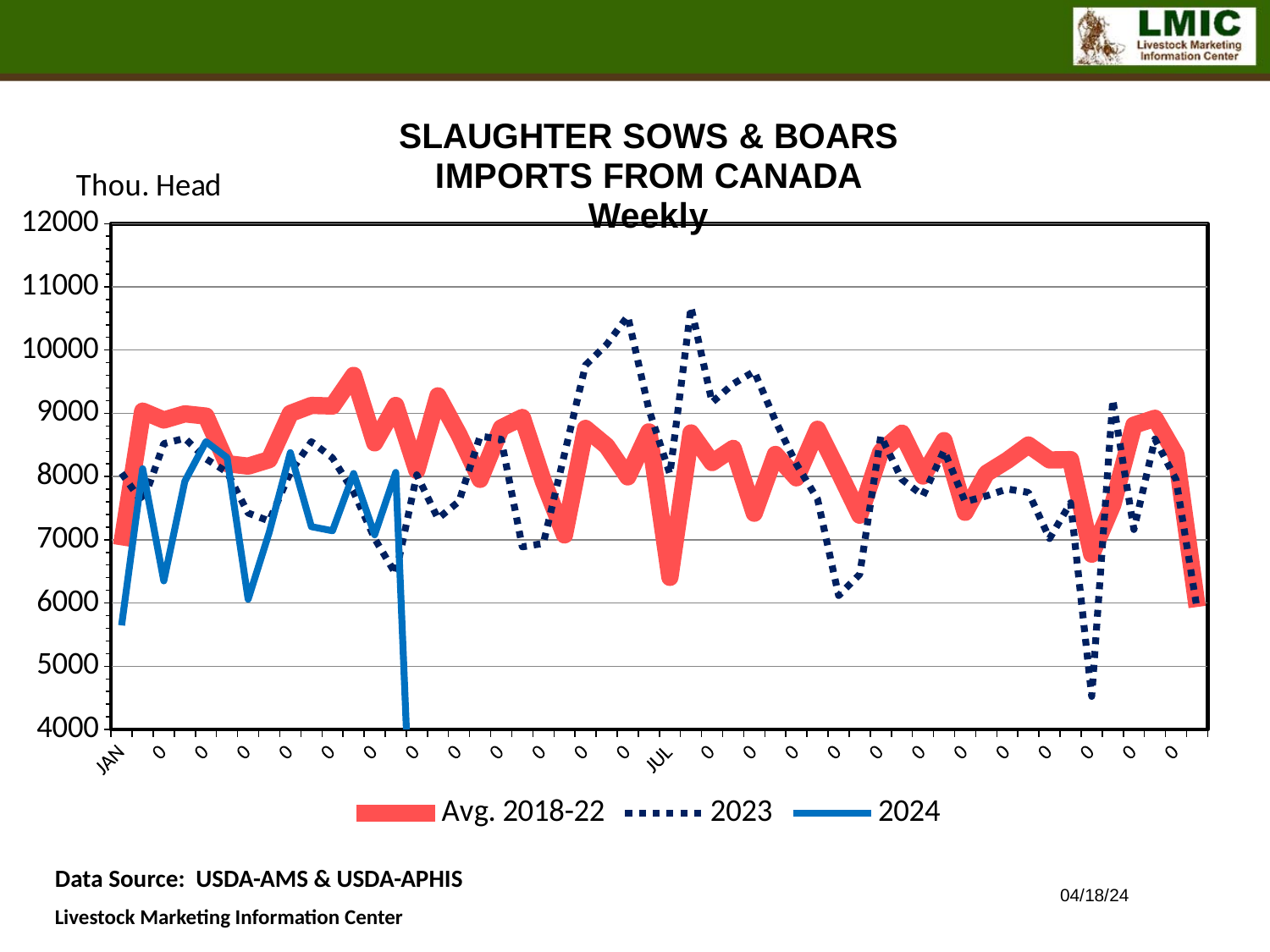
Is the first (JAN) value of the 2024 series greater or less than 6000? less Is the highest value of the Avg. 2018-22 series greater or less than 10000? less Which series reaches a higher peak value, 2023 or Avg. 2018-22? 2023 What kind of chart is shown on the slide? line chart Is the final value of the Avg. 2018-22 series at the right end of the chart greater or less than 7000? less How many series does the legend list? 3 Does the Avg. 2018-22 series rise or fall over the last few weeks at the right end of the chart? fall What are the three series named in the legend? Avg. 2018-22, 2023, 2024 Which series is plotted for only the first part of the year? 2024 What is the title of the chart? SLAUGHTER SOWS & BOARS IMPORTS FROM CANADA Weekly